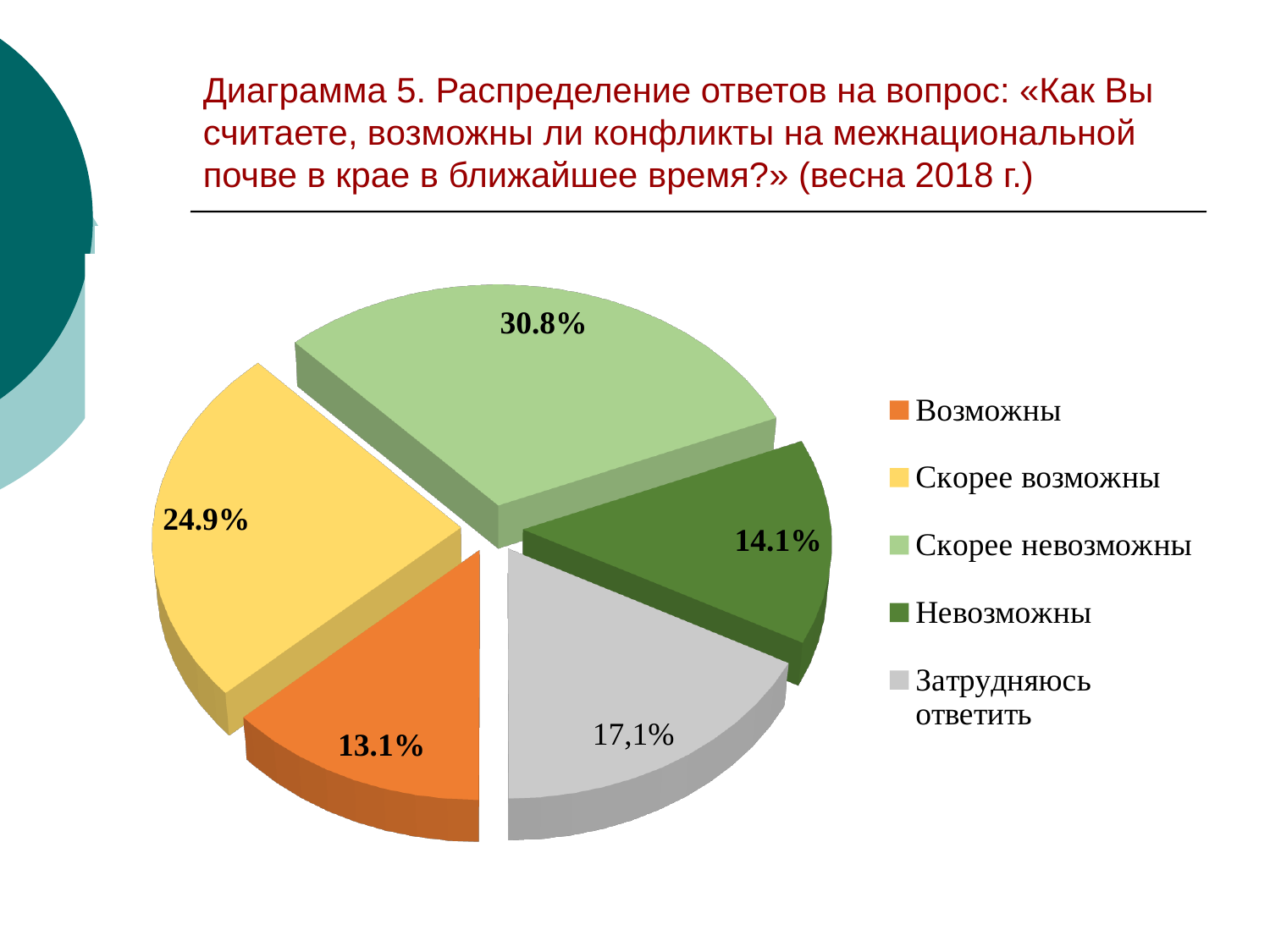
What is the difference in percentage points between «Скорее невозможны» and «Скорее возможны»? 5.9 What percentage of respondents answered «Невозможны»? 14.1% What is the combined share of «Возможны» and «Скорее возможны»? 38.0% What colour is the slice for «Скорее возможны»? Yellow Which answer option has the smallest share of the pie? Возможны Which is larger: the share for «Скорее возможны» or the share for «Затрудняюсь ответить»? Скорее возможны How many answer options (slices) does the pie chart show? 5 What percentage of respondents answered «Затрудняюсь ответить»? 17,1% Which answer option has the largest share of the pie? Скорее невозможны What percentage of respondents answered «Возможны»? 13.1% What type of chart is shown on the slide? Pie chart What percentage of respondents answered «Скорее невозможны»? 30.8%